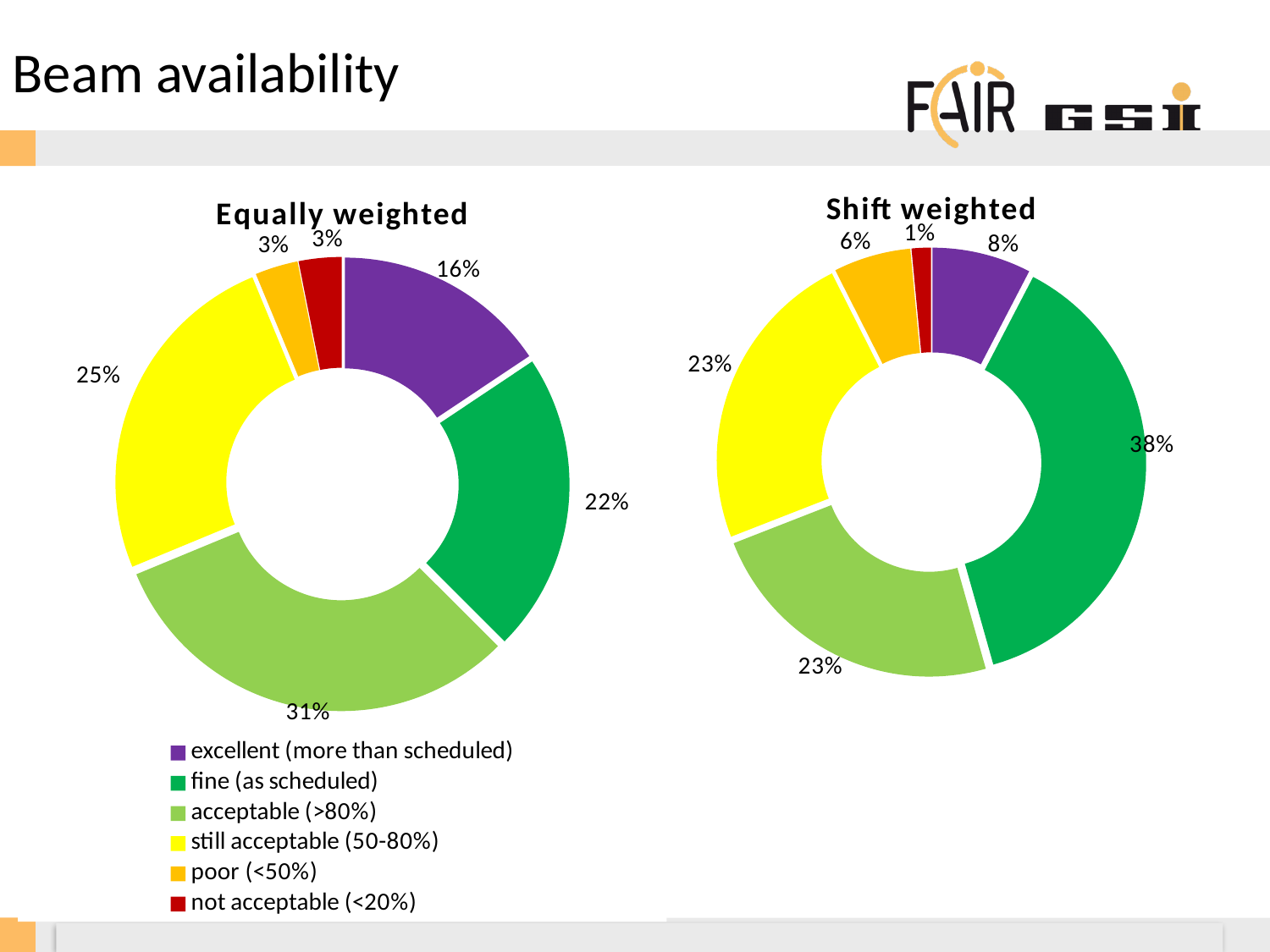
In the "Equally weighted" chart, what share is labelled for the "acceptable (>80%)" category? 31% In the "Shift weighted" chart, what share is labelled for the "fine (as scheduled)" category? 38% What kind of chart is the "Shift weighted" chart? Doughnut (pie) chart In the "Shift weighted" chart, which category has the smallest share? not acceptable (<20%) In the "Equally weighted" chart, which is larger: the share for "still acceptable (50-80%)" or the share for "fine (as scheduled)"? still acceptable (50-80%) In the "Equally weighted" chart, which category has the largest share? acceptable (>80%) What is the title of the chart on the left of the slide? Equally weighted In the "Shift weighted" chart, what share is labelled for "not acceptable (<20%)"? 1% How many categories does the legend list for the charts? 6 Which colour represents "poor (<50%)" in the charts? Orange In the "Shift weighted" chart, what is the difference between the shares for "fine (as scheduled)" and "excellent (more than scheduled)"? 30% In the "Equally weighted" chart, what share is labelled for "excellent (more than scheduled)"? 16%